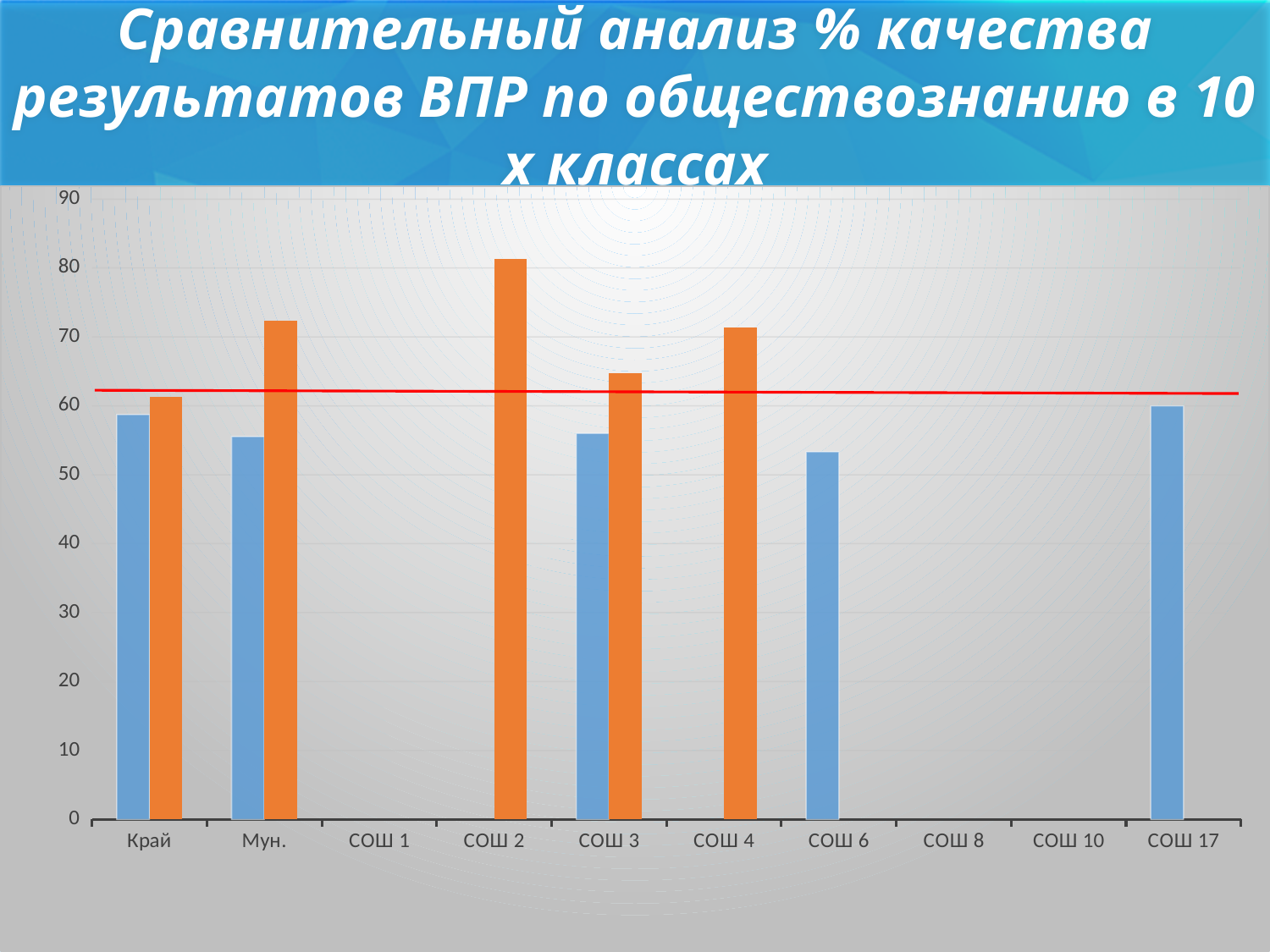
Which is taller: the orange bar for Мун. or the orange bar for СОШ 3? Мун. Is the blue bar for Край greater or less than 60? less What kind of chart is shown on the slide? bar chart How many categories are shown on the x axis of the chart? 10 Which is taller: the orange bar for СОШ 2 or the orange bar for СОШ 4? СОШ 2 Which category has the tallest bar in the chart? СОШ 2 What colour is the horizontal line drawn across the chart? red Is the blue bar for Мун. greater or less than 60? less Is the orange bar for СОШ 2 greater or less than 80? greater